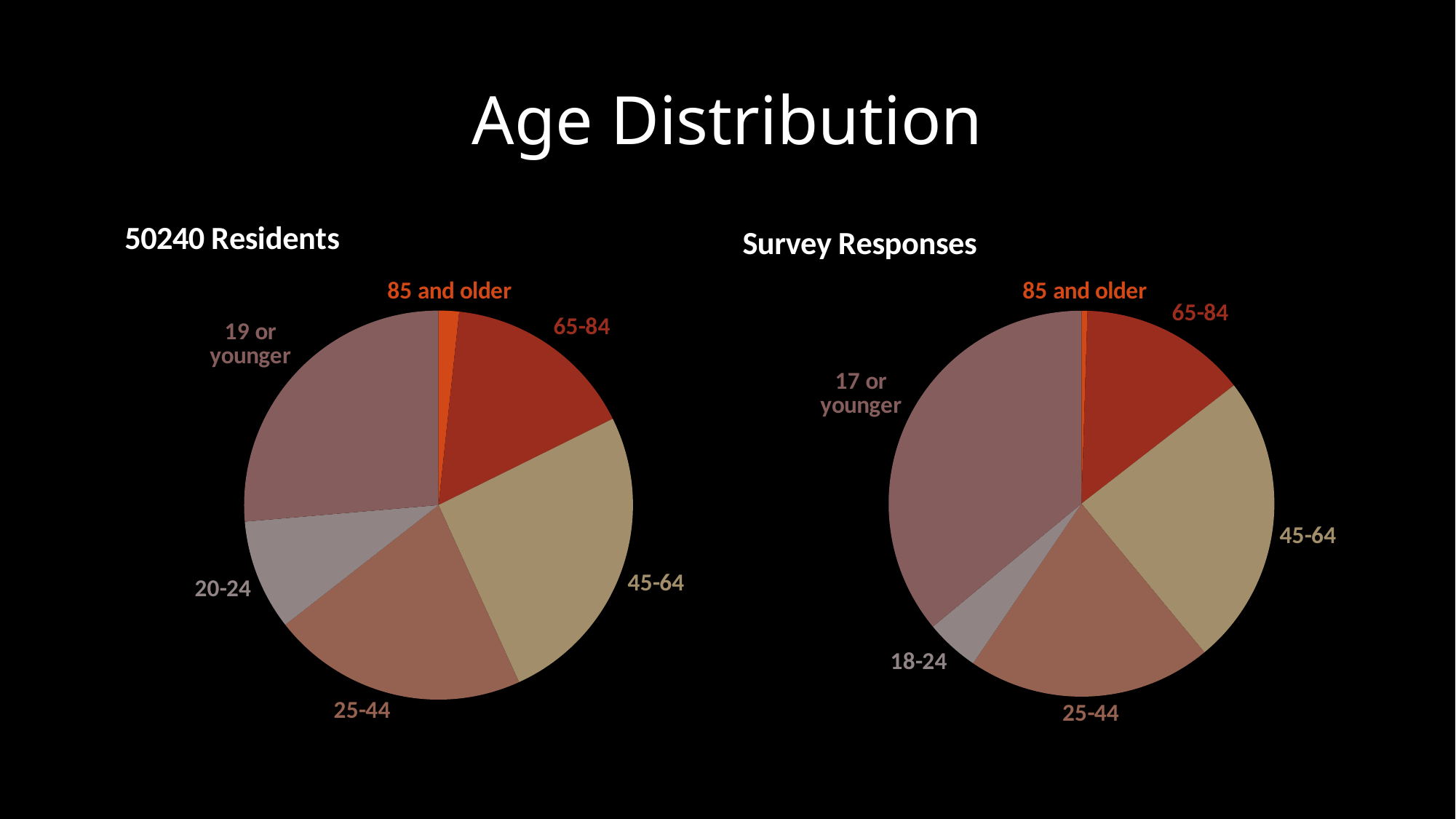
What is the title of the slide containing the two pie charts? Age Distribution In the '50240 Residents' chart, which age category has the largest slice? 19 or younger How many age categories are shown in the 'Survey Responses' pie chart? 6 What is the youngest age category label in the 'Survey Responses' chart? 17 or younger In the '50240 Residents' chart, which slice is larger: 45-64 or 20-24? 45-64 In the 'Survey Responses' chart, which slice is larger: 25-44 or 18-24? 25-44 What type of chart is the '50240 Residents' chart? pie chart In the 'Survey Responses' chart, which age category has the largest slice? 17 or younger How many age categories are shown in the '50240 Residents' pie chart? 6 In the 'Survey Responses' chart, which age category has the smallest slice? 85 and older What type of chart is the 'Survey Responses' chart? pie chart In the '50240 Residents' chart, which age category has the smallest slice? 85 and older